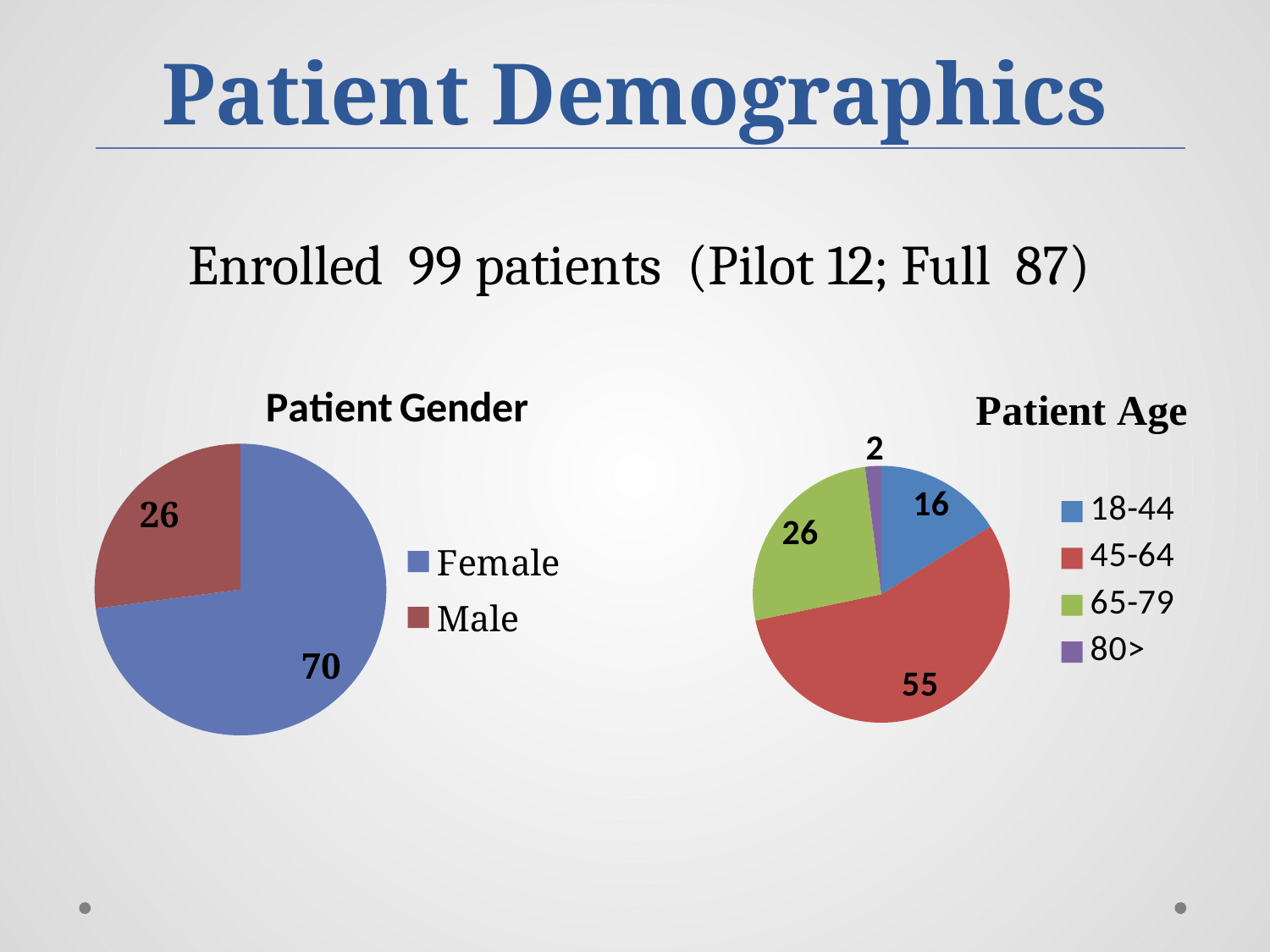
In the Patient Gender chart, what is the difference between the Female and Male values? 44 In the Patient Age chart, which age group has the smallest value? 80> In the Patient Age chart, which age group has the largest value? 45-64 What kind of chart is the Patient Gender chart? Pie chart In the Patient Gender chart, what is the value for Female? 70 In the Patient Age chart, what is the difference between the 65-79 and 18-44 values? 10 In the Patient Gender chart, what is the value for Male? 26 How many age groups does the legend of the Patient Age chart list? 4 In the Patient Age chart, what is the value for the 18-44 age group? 16 In the Patient Gender chart, which category is larger, Female or Male? Female In the Patient Age chart, what is the value for the 45-64 age group? 55 In the Patient Age chart, what colour is the slice for the 65-79 age group? Green